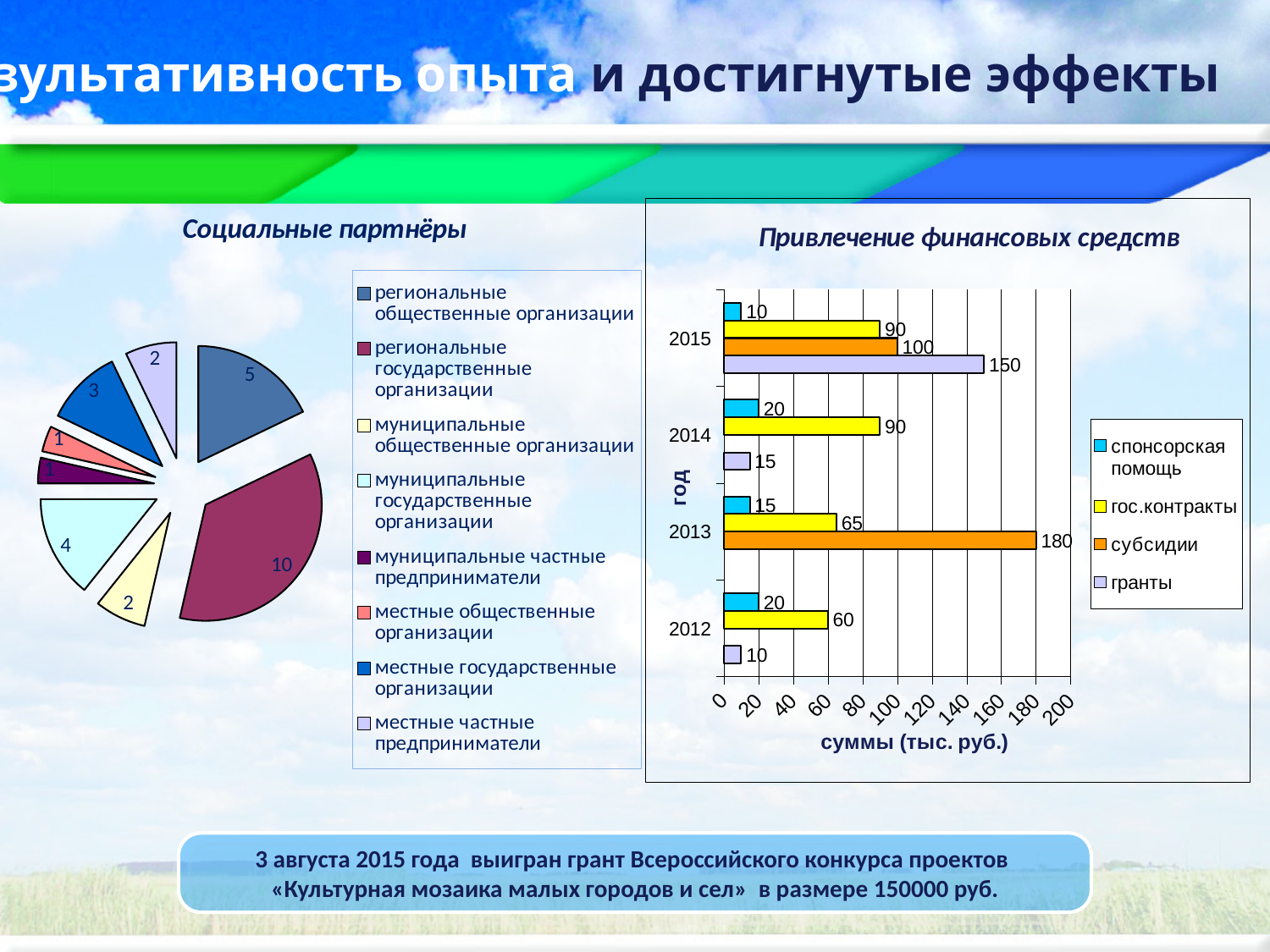
In the chart 'Привлечение финансовых средств', what is the value of субсидии for 2013? 180 In the chart 'Привлечение финансовых средств', what is the value of гранты for 2015? 150 In the chart 'Привлечение финансовых средств', which year has the highest value for гос.контракты? 2014 and 2015 (both 90) In the chart 'Привлечение финансовых средств', what kind of chart is shown? Bar chart In the chart 'Привлечение финансовых средств', what is the difference between субсидии in 2013 and субсидии in 2015? 80 In the pie chart 'Социальные партнёры', how many categories does the legend list? 8 In the pie chart 'Социальные партнёры', what is the value for региональные государственные организации? 10 In the pie chart 'Социальные партнёры', which category has the largest slice? региональные государственные организации In the chart 'Привлечение финансовых средств', what is the value of гос.контракты for 2012? 60 In the chart 'Привлечение финансовых средств', which is larger: спонсорская помощь in 2014 or спонсорская помощь in 2015? 2014 In the chart 'Привлечение финансовых средств', how many series does the legend list? 4 In the pie chart 'Социальные партнёры', what is the difference between региональные государственные организации and региональные общественные организации? 5